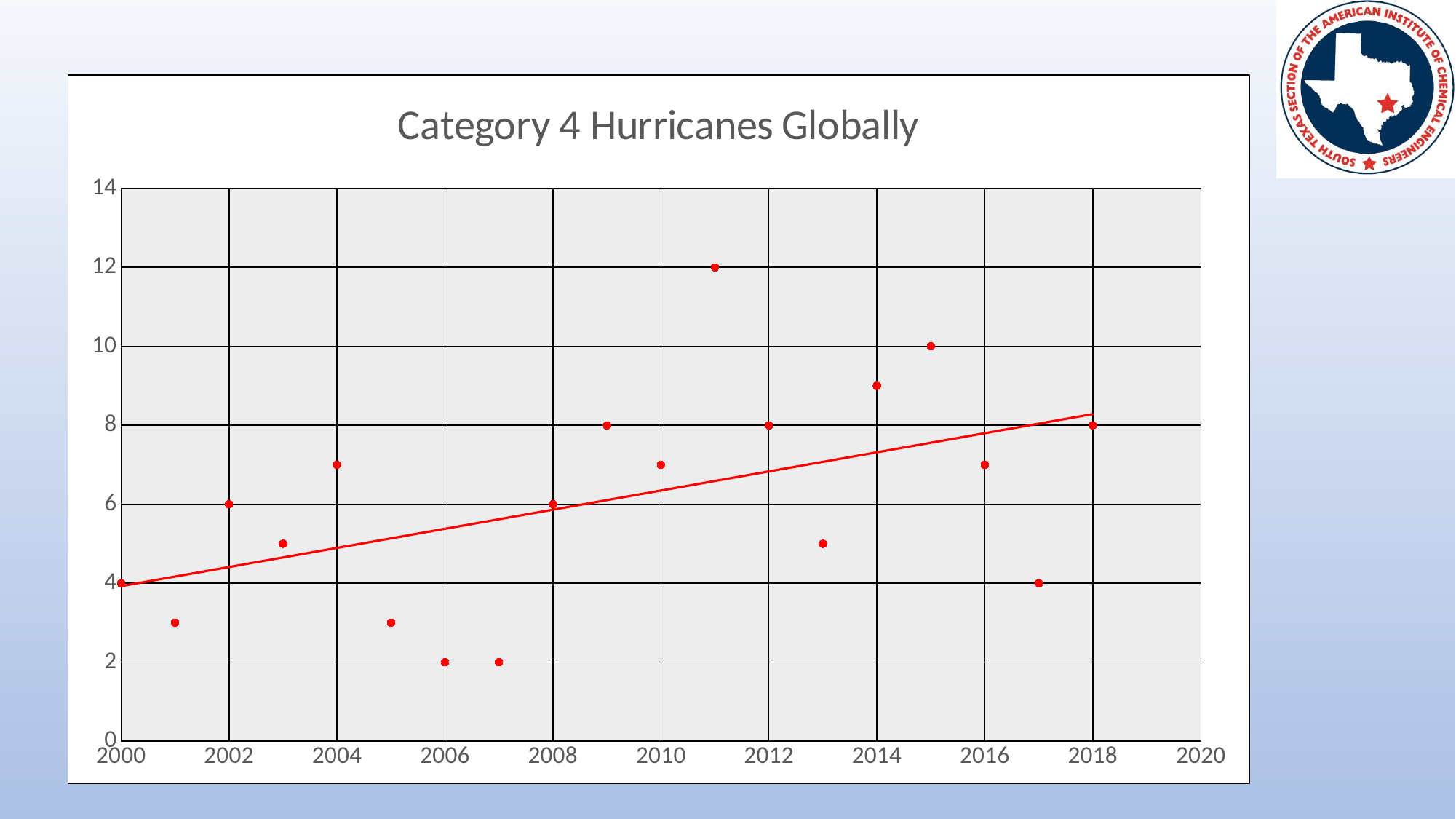
What kind of chart is shown on the slide? scatter chart Is the value for 2014 greater or less than 8? greater Is the value for 2005 greater or less than 4? less What is the value plotted for 2018? 8 Which year has the larger value, 2009 or 2017? 2009 What is the value plotted for 2015? 10 What is the title of the chart? Category 4 Hurricanes Globally Does the trend line rise or fall from 2000 to 2018? rises What is the value plotted for 2006? 2 What is the difference between the values for 2011 and 2018? 4 Which year has the highest number of Category 4 hurricanes? 2011 What is the value plotted for 2011? 12